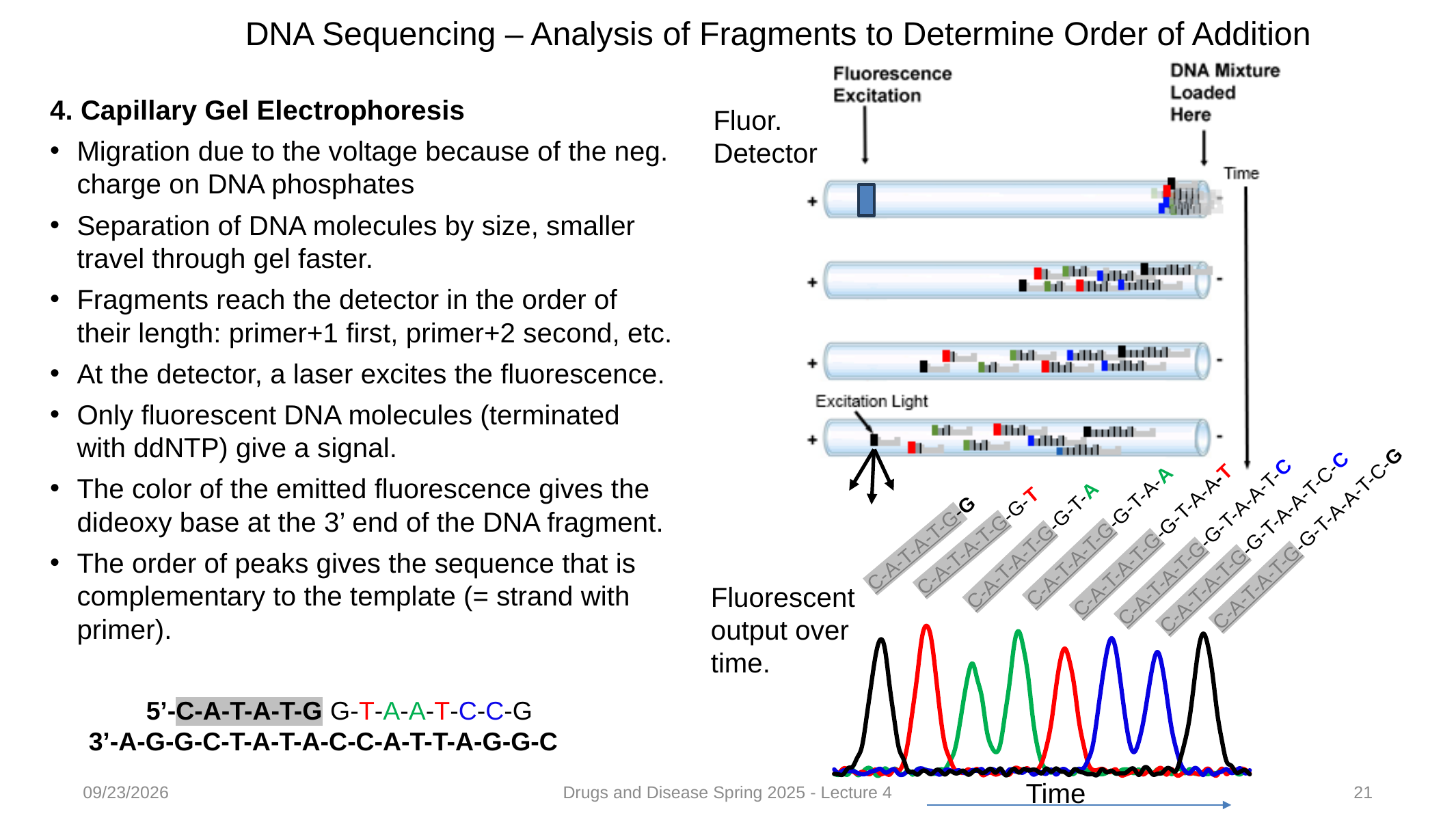
In the 'Fluorescent output over time' trace, what is the label on the horizontal axis? Time In the 'Fluorescent output over time' trace, how many peaks are shown? 8 In the 'Fluorescent output over time' trace, how many green peaks are there? 2 In the 'Fluorescent output over time' trace, what colour is the first peak (leftmost)? black In the 'Fluorescent output over time' trace, what colour are the sixth and seventh peaks? blue What kind of chart is the 'Fluorescent output over time' plot? line chart In the 'Fluorescent output over time' trace, which is taller: the first red peak or the second red peak? the first red peak In the 'Fluorescent output over time' trace, what colour is the last peak (rightmost)? black In the 'Fluorescent output over time' trace, which is taller: the first green peak or the second green peak? the second green peak In the 'Fluorescent output over time' trace, what colour is the second peak? red In the 'Fluorescent output over time' trace, how many different colours of trace are plotted? 4